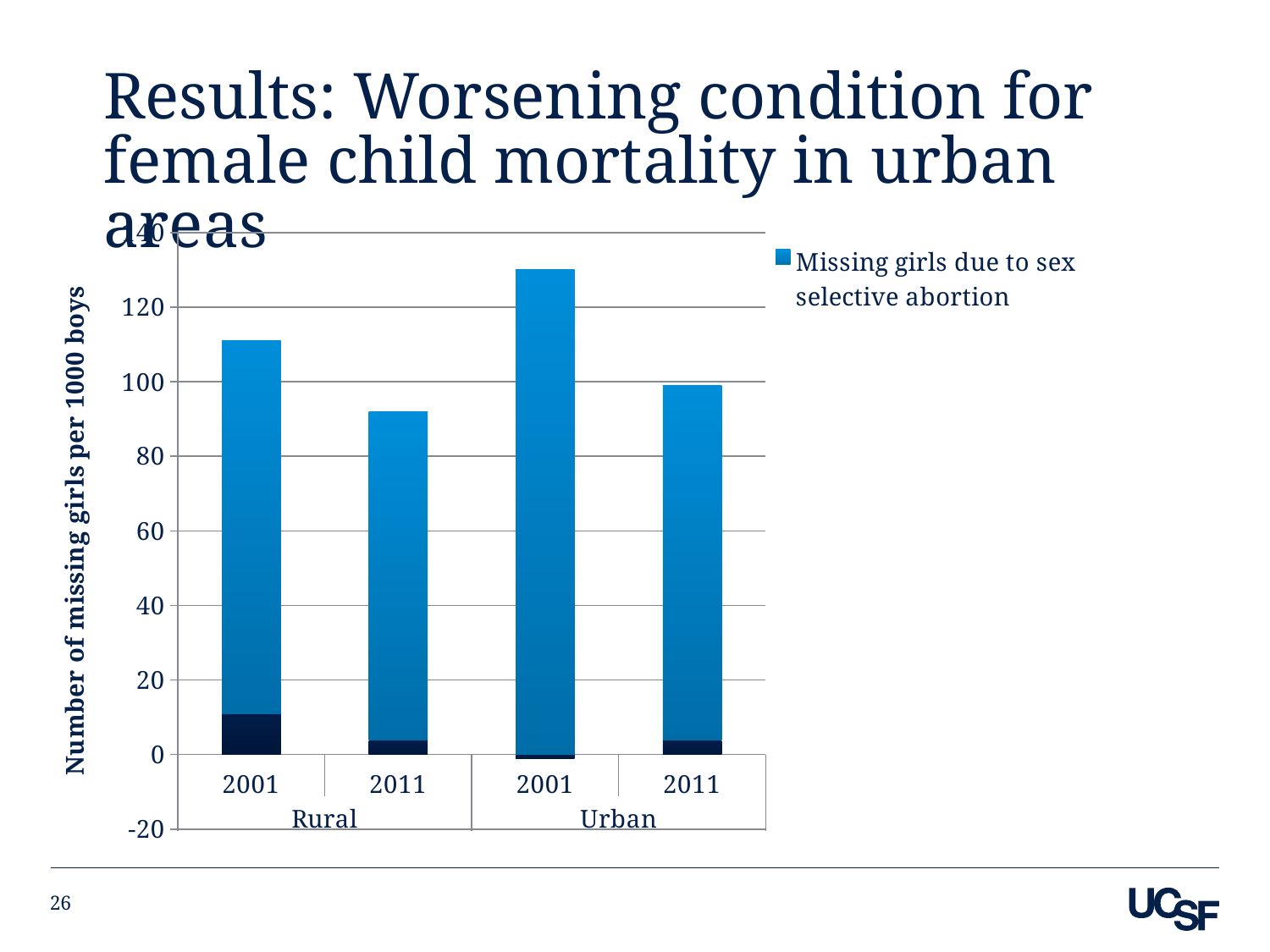
Which bar is the tallest in the chart? Urban 2001 Which bar is the shortest in the chart? Rural 2011 Do the Urban values rise or fall from 2001 to 2011? fall Is the value for Rural 2011 greater or less than 100? less How many bars are plotted in the chart? 4 Is the value for Urban 2001 greater or less than 120? greater What kind of chart is shown on the slide? Bar chart Is the value for Rural 2001 greater or less than 100? greater What is the legend entry shown for the chart? Missing girls due to sex selective abortion How many series does the chart's legend list? 1 Which is larger, the bar for Rural 2001 or the bar for Urban 2001? Urban 2001 What is the title of the vertical axis? Number of missing girls per 1000 boys